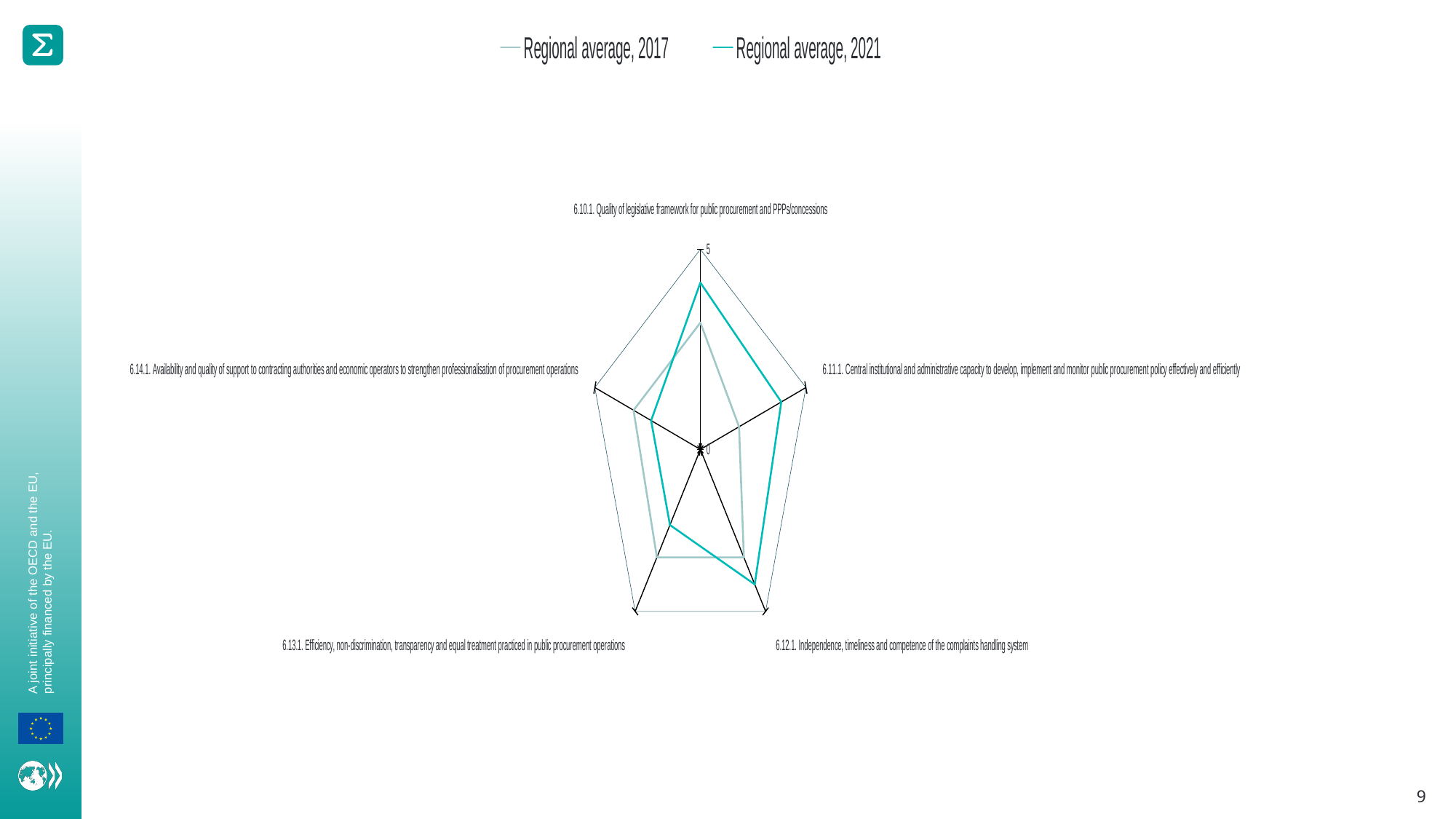
What are the two series named in the legend? Regional average, 2017 and Regional average, 2021 For indicator 6.12.1 (Independence, timeliness and competence of the complaints handling system), which series has the larger value? Regional average, 2021 For indicator 6.14.1 (Availability and quality of support to contracting authorities and economic operators), is the Regional average for 2021 higher or lower than for 2017? Lower For indicator 6.11.1 (Central institutional and administrative capacity), is the Regional average for 2021 higher or lower than for 2017? Higher How many indicator axes (categories) does the radar chart have? 5 What kind of chart is shown on the slide? Radar chart What is the maximum value shown on the radar chart's axis scale? 5 How many series does the legend list? 2